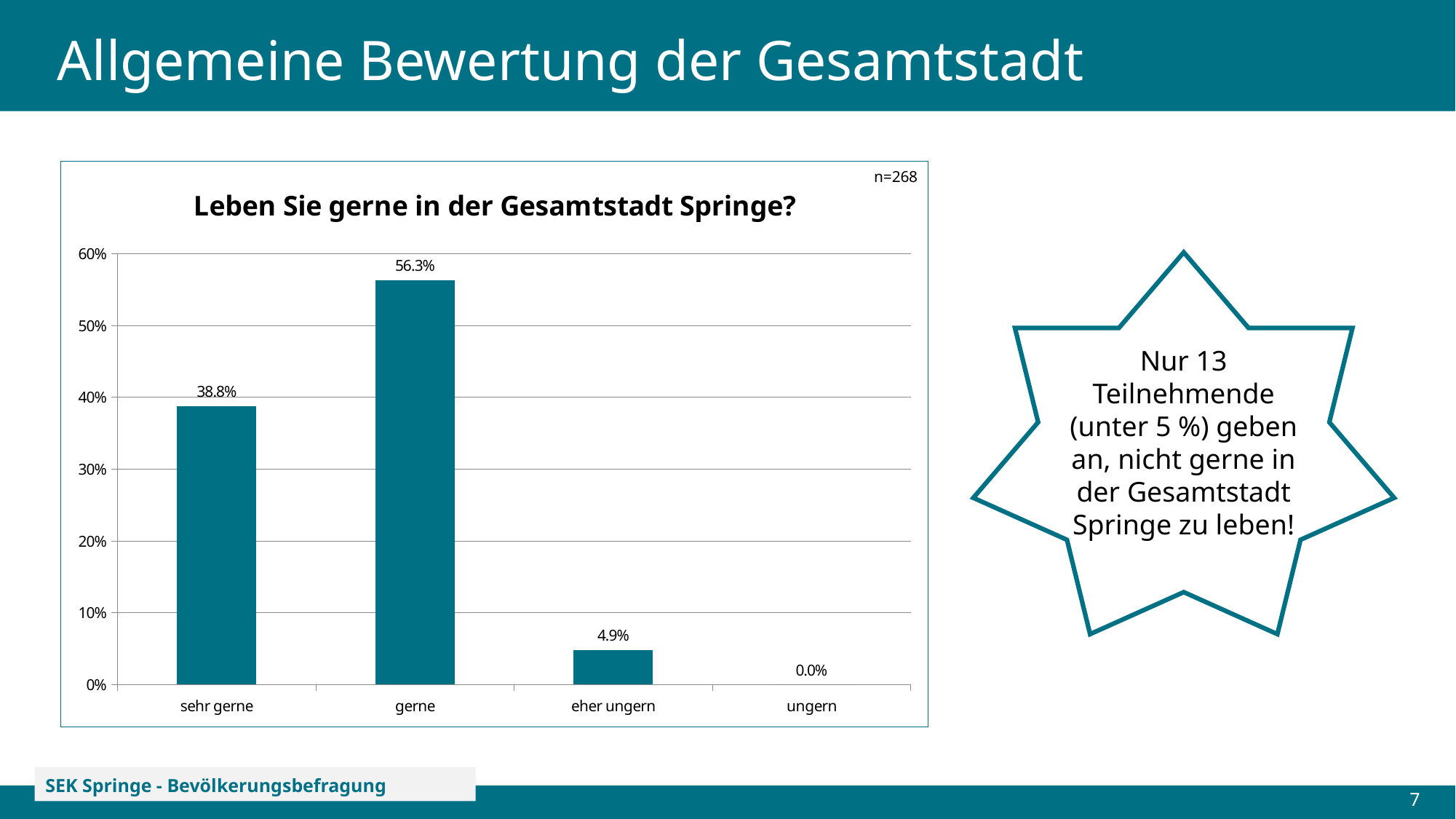
What is the difference between the values for "gerne" and "sehr gerne"? 17.5% What is the value for "gerne"? 56.3% What is the value for "ungern"? 0.0% Which category has the lowest value? ungern What is the title of the chart? Leben Sie gerne in der Gesamtstadt Springe? What kind of chart is shown? bar chart Which is larger, the value for "sehr gerne" or the value for "eher ungern"? sehr gerne Is the value for "gerne" greater or less than 50%? greater Which category has the highest value? gerne What is the value for "sehr gerne"? 38.8% What is the value for "eher ungern"? 4.9% How many categories are shown on the x axis? 4